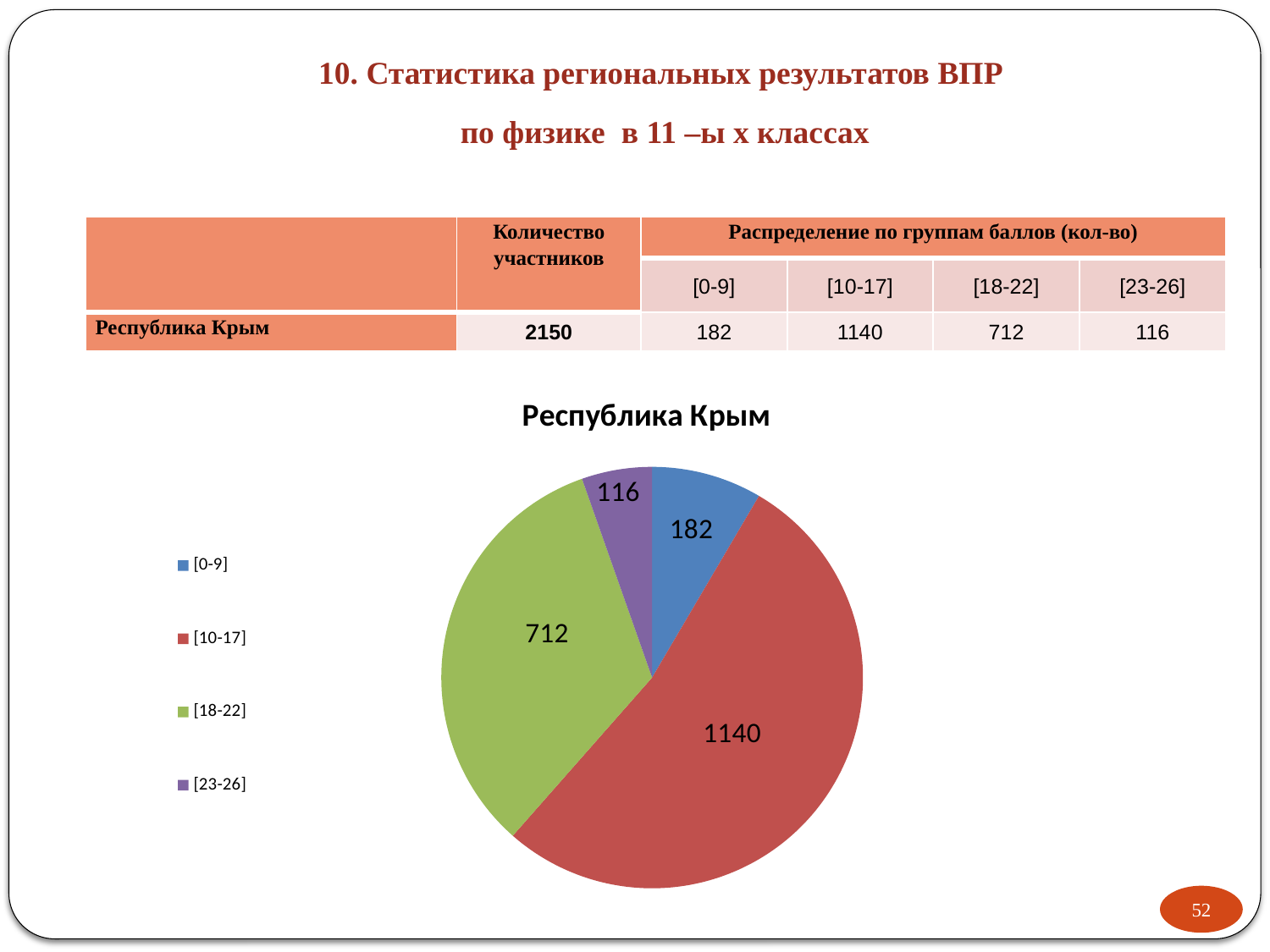
What is the value of the [0-9] slice in the pie chart? 182 How many entries does the legend of the pie chart list? 4 What is the difference between the [10-17] and [18-22] values in the pie chart? 428 Which score group has the smallest slice in the pie chart? [23-26] What is the value of the [10-17] slice in the pie chart? 1140 Which score group has the largest slice in the pie chart? [10-17] How many slices does the pie chart have? 4 Which is larger in the pie chart, the [0-9] slice or the [18-22] slice? [18-22] What is the title of the pie chart? Республика Крым What is the value of the [23-26] slice in the pie chart? 116 What kind of chart is shown on the slide? pie chart What is the total of all four slices in the pie chart? 2150